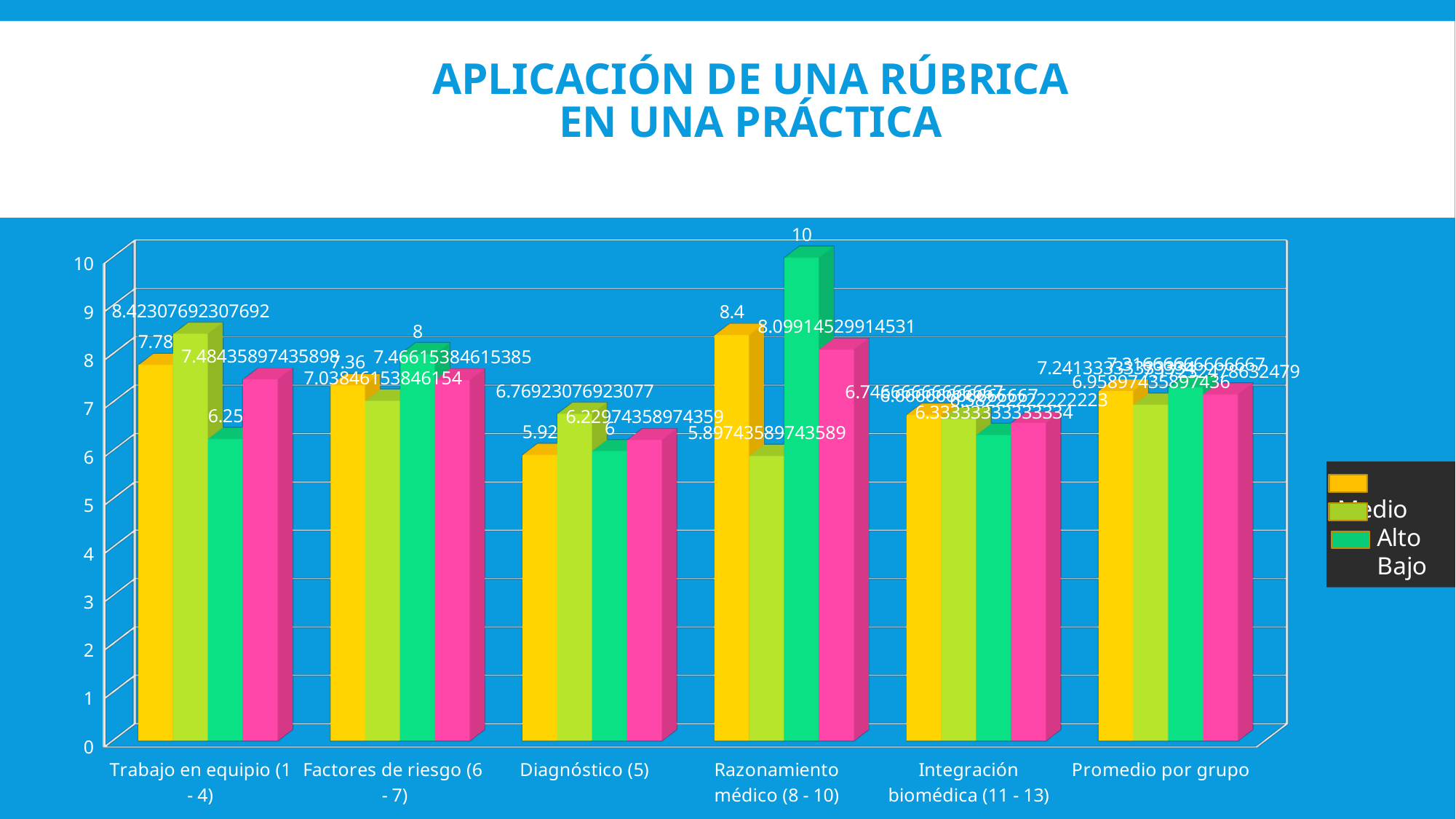
What kind of chart is shown on the slide? Bar chart What is the Alto value for Trabajo en equipo (1 - 4)? 6.25 How many categories are shown along the x axis of the chart? 6 Which category has the lowest Alto value? Diagnóstico (5) For Razonamiento médico (8 - 10), which is larger: the Alto value or the Medio value? Alto What is the difference between the Alto value for Razonamiento médico (8 - 10) and the Alto value for Trabajo en equipo (1 - 4)? 3.75 How many series does the chart's legend list? 4 What is the Alto value for Factores de riesgo (6 - 7)? 8 Is the Bajo value for Trabajo en equipo (1 - 4) greater or less than 7? greater What is the Alto value for Razonamiento médico (8 - 10)? 10 What is the Medio value for Trabajo en equipo (1 - 4)? 8.42307692307692 Which category has the highest Alto value? Razonamiento médico (8 - 10)